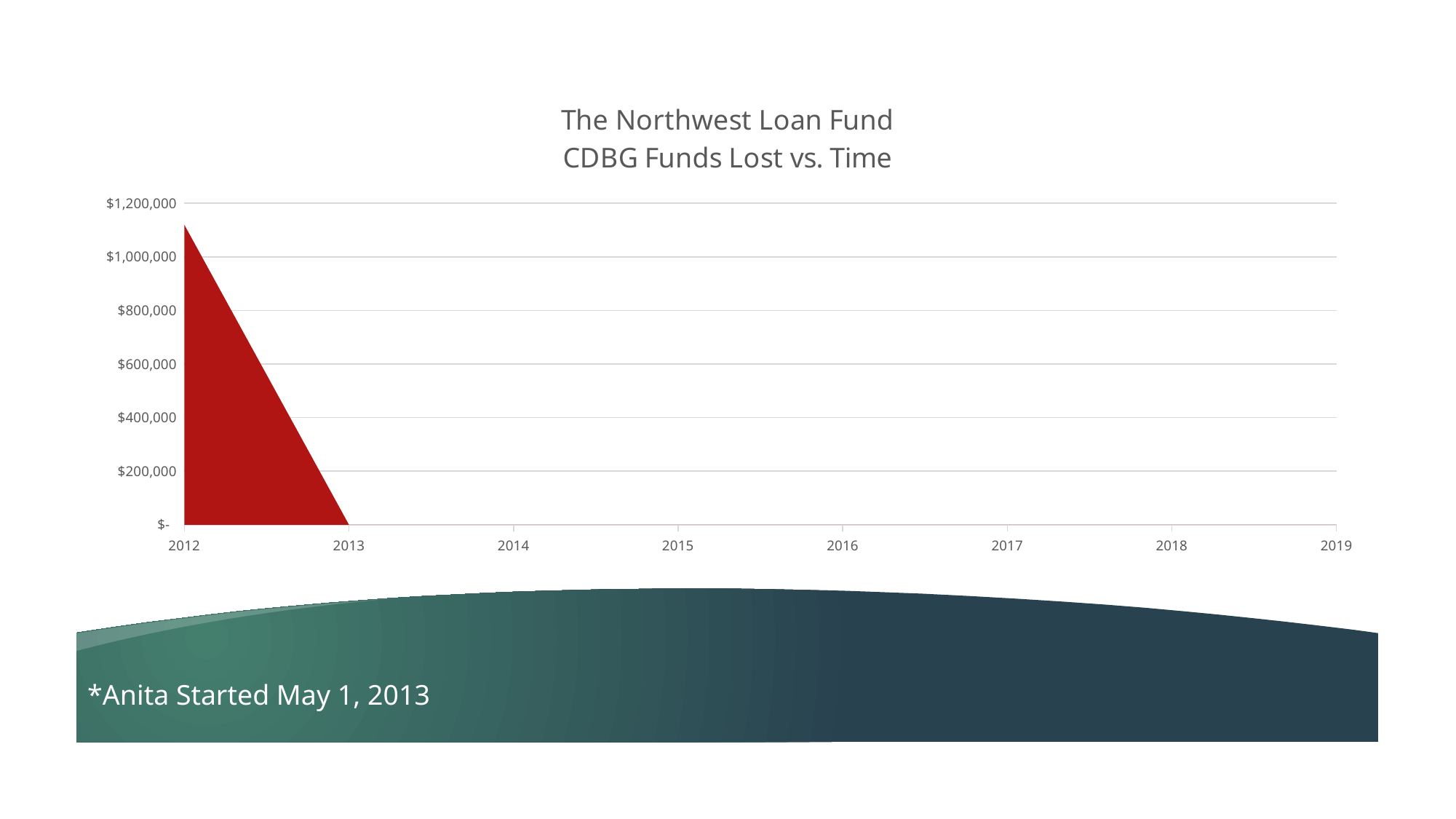
What kind of chart is shown on the slide? area chart What is the value of CDBG funds lost in 2013? $- What is the title of the chart? The Northwest Loan Fund CDBG Funds Lost vs. Time Is the value for 2012 greater or less than $1,000,000? greater Which is larger, the value for 2012 or the value for 2013? 2012 Do the values rise or fall from 2012 to 2013? fall Which year has the highest value of CDBG funds lost? 2012 Is the value for 2012 greater or less than $1,200,000? less How many years are labelled along the x axis of the chart? 8 What is the last year shown on the x axis? 2019 What colour is the shaded area in the chart? red What is the highest value labelled on the y axis? $1,200,000